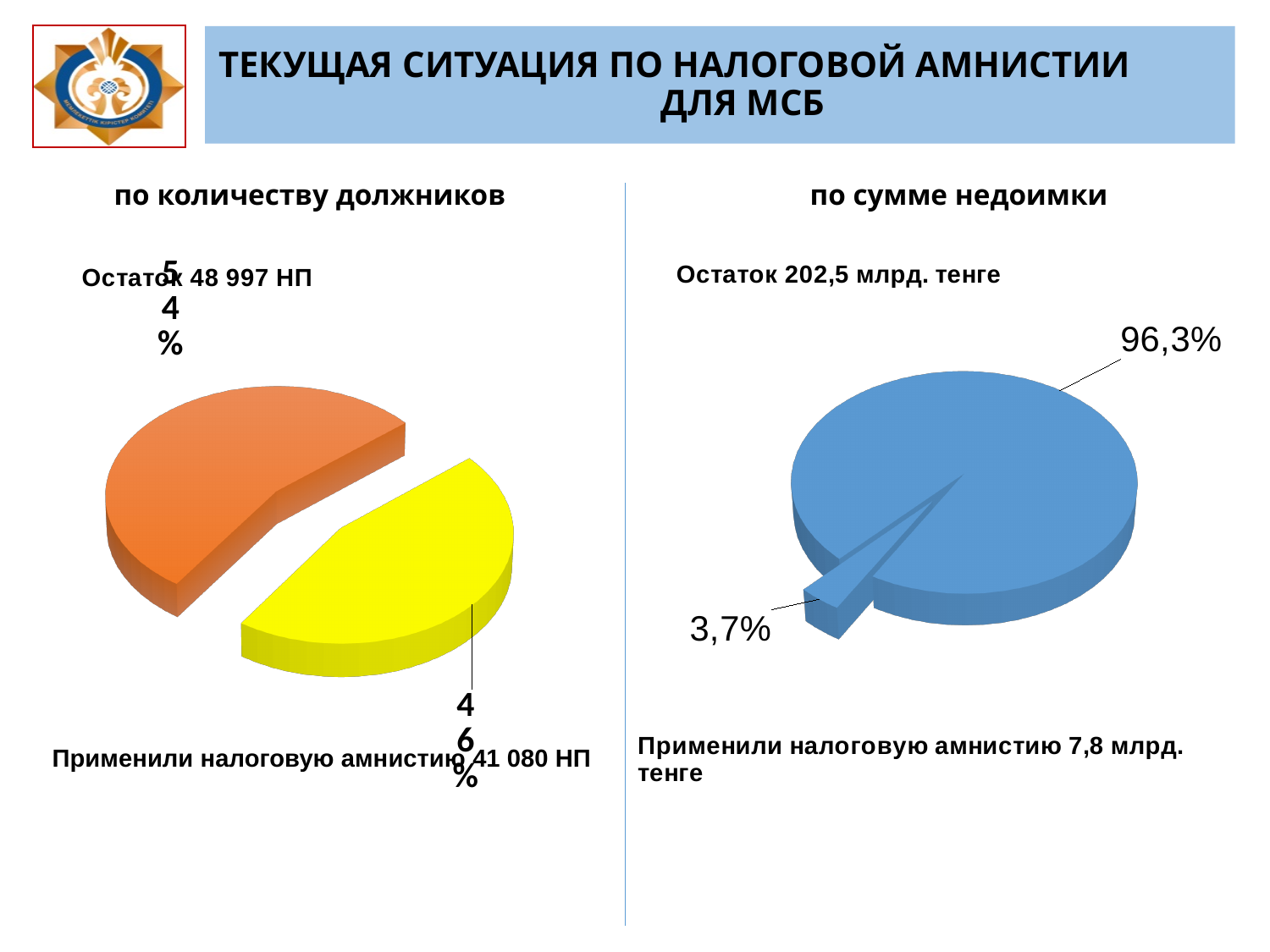
What type of chart is shown on the left under "по количеству должников"? pie chart In the left chart ("по количеству должников"), how many taxpayers (НП) are shown for "Применили налоговую амнистию"? 41 080 НП In the left chart ("по количеству должников"), how many taxpayers (НП) are shown for "Остаток"? 48 997 НП What type of chart is shown on the right under "по сумме недоимки"? pie chart In the left chart ("по количеству должников"), what share is labelled on the orange slice for "Остаток"? 54% In the right chart ("по сумме недоимки"), what amount is shown for "Остаток"? 202,5 млрд. тенге In the left chart ("по количеству должников"), what is the difference in percentage points between the "Остаток" slice and the "Применили налоговую амнистию" slice? 8% In the right chart ("по сумме недоимки"), what share is labelled on the small exploded slice? 3,7% In the left chart ("по количеству должников"), what share is labelled on the yellow slice for "Применили налоговую амнистию"? 46% In the right chart ("по сумме недоимки"), what amount is shown for "Применили налоговую амнистию"? 7,8 млрд. тенге In the right chart ("по сумме недоимки"), which slice is larger: "Остаток" or "Применили налоговую амнистию"? Остаток